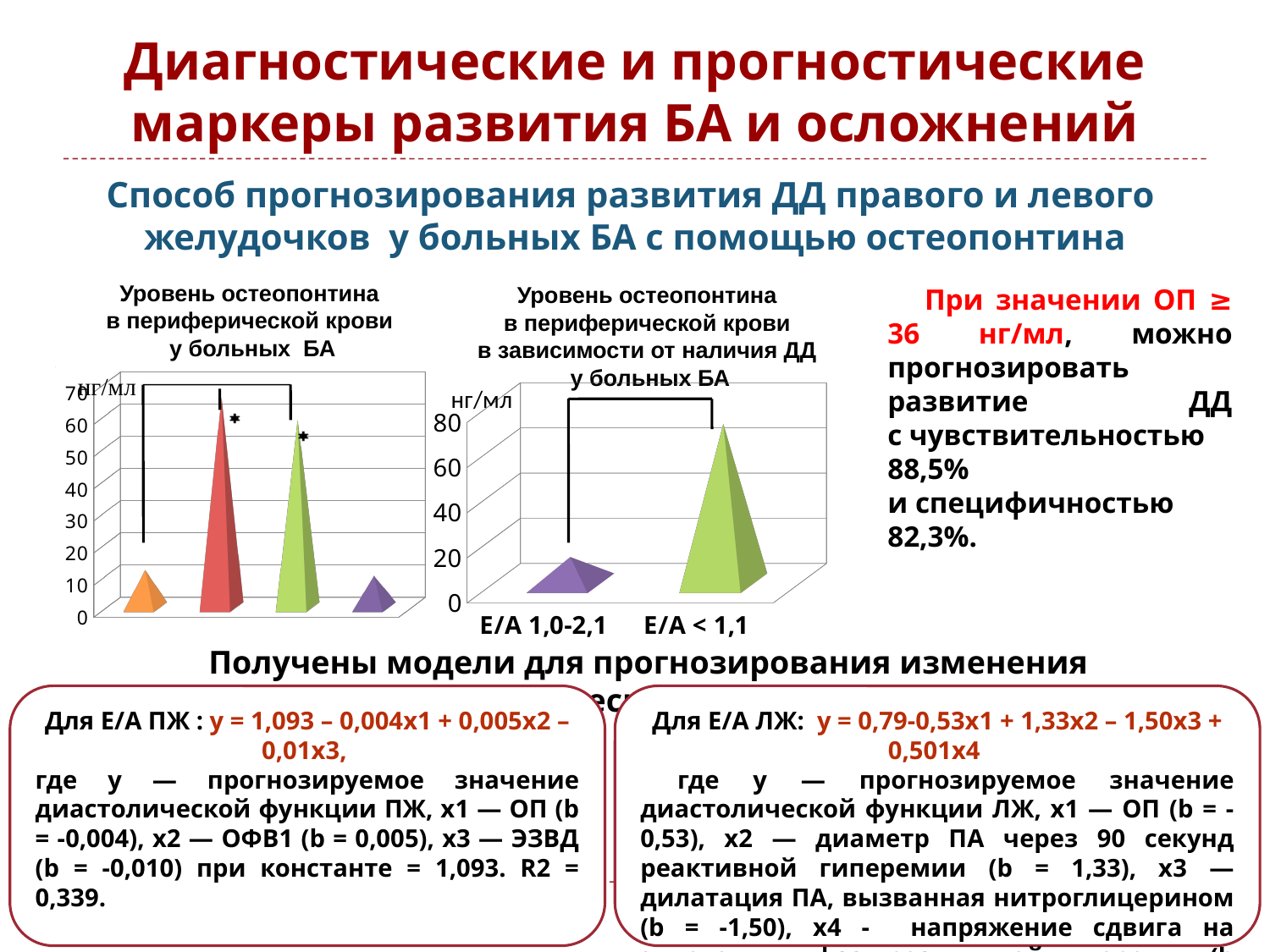
In the right-hand chart, which category has the lowest osteopontin level? E/A 1,0-2,1 In the right-hand chart, is the value for E/A 1,0-2,1 greater or less than 40? less In the left-hand chart, is the value of the orange bar greater or less than 30? less In the left-hand chart, is the value of the red bar greater or less than 40? greater What unit is shown on the y axis of the right-hand chart? нг/мл What is the highest tick value on the y axis of the left-hand chart? 70 In the right-hand chart, which is larger: the value for E/A 1,0-2,1 or the value for E/A < 1,1? E/A < 1,1 In the right-hand chart, how many categories are shown on the x axis? 2 What kind of chart is the right-hand chart titled 'Уровень остеопонтина в периферической крови в зависимости от наличия ДД у больных БА'? bar chart In the left-hand chart titled 'Уровень остеопонтина в периферической крови у больных БА', how many bars are plotted? 4 In the right-hand chart, which category has the highest osteopontin level? E/A < 1,1